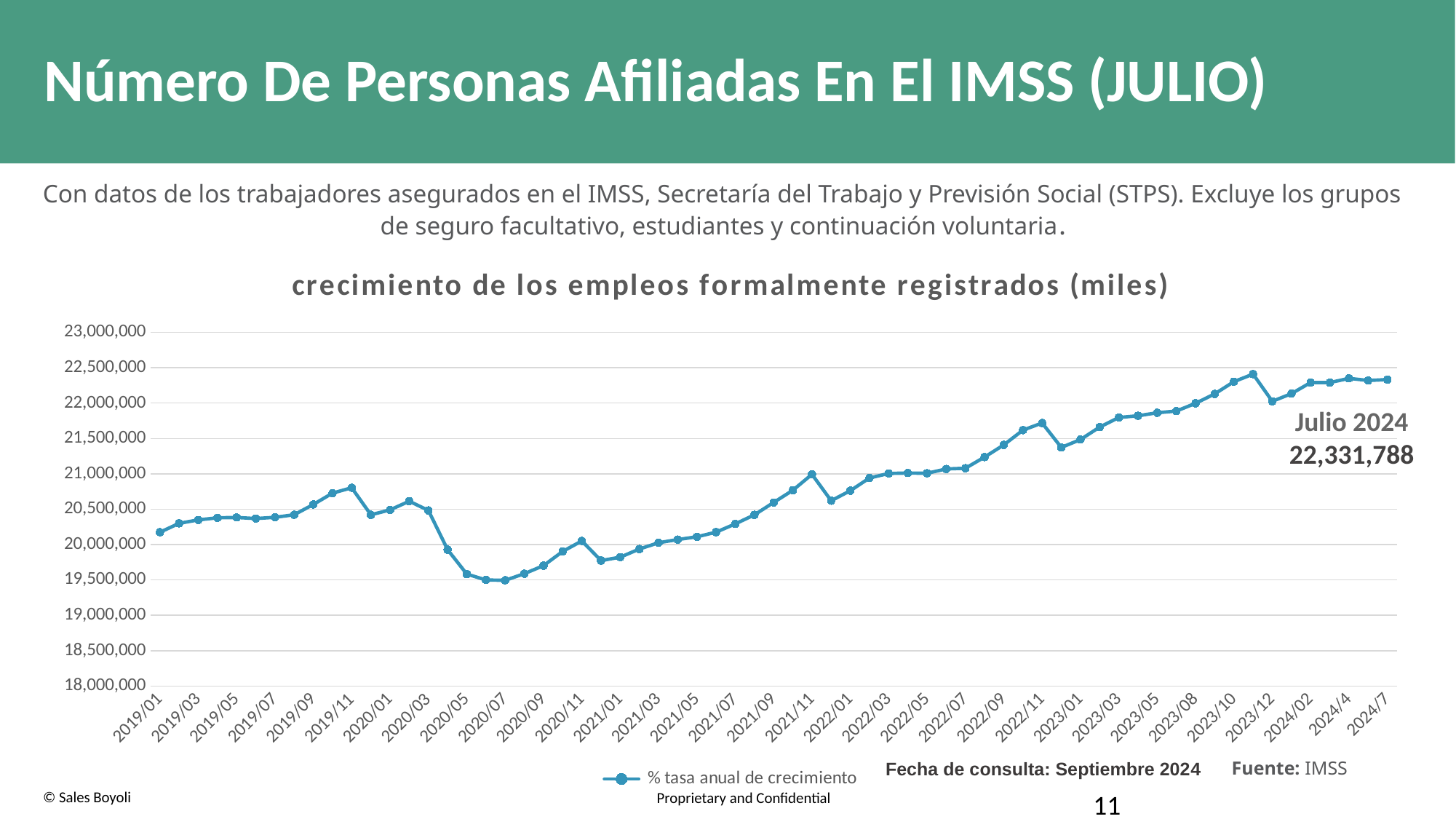
Is the value for 2023/10 greater or less than 22,000,000? greater Is the value for 2019/01 greater or less than 20,500,000? less Which is larger, the value for 2020/07 or the value for 2022/07? 2022/07 What is the legend entry for the plotted series? % tasa anual de crecimiento Overall, do the values rise or fall from 2019/01 to 2024/7? rise How many series does the chart legend list? 1 What is the title of the chart? crecimiento de los empleos formalmente registrados (miles) Is the value for 2022/11 greater or less than 21,500,000? greater Do the values rise or fall between 2019/11 and 2020/07? fall What is the value labelled for Julio 2024 on the chart? 22,331,788 What kind of chart is shown on the slide? line chart